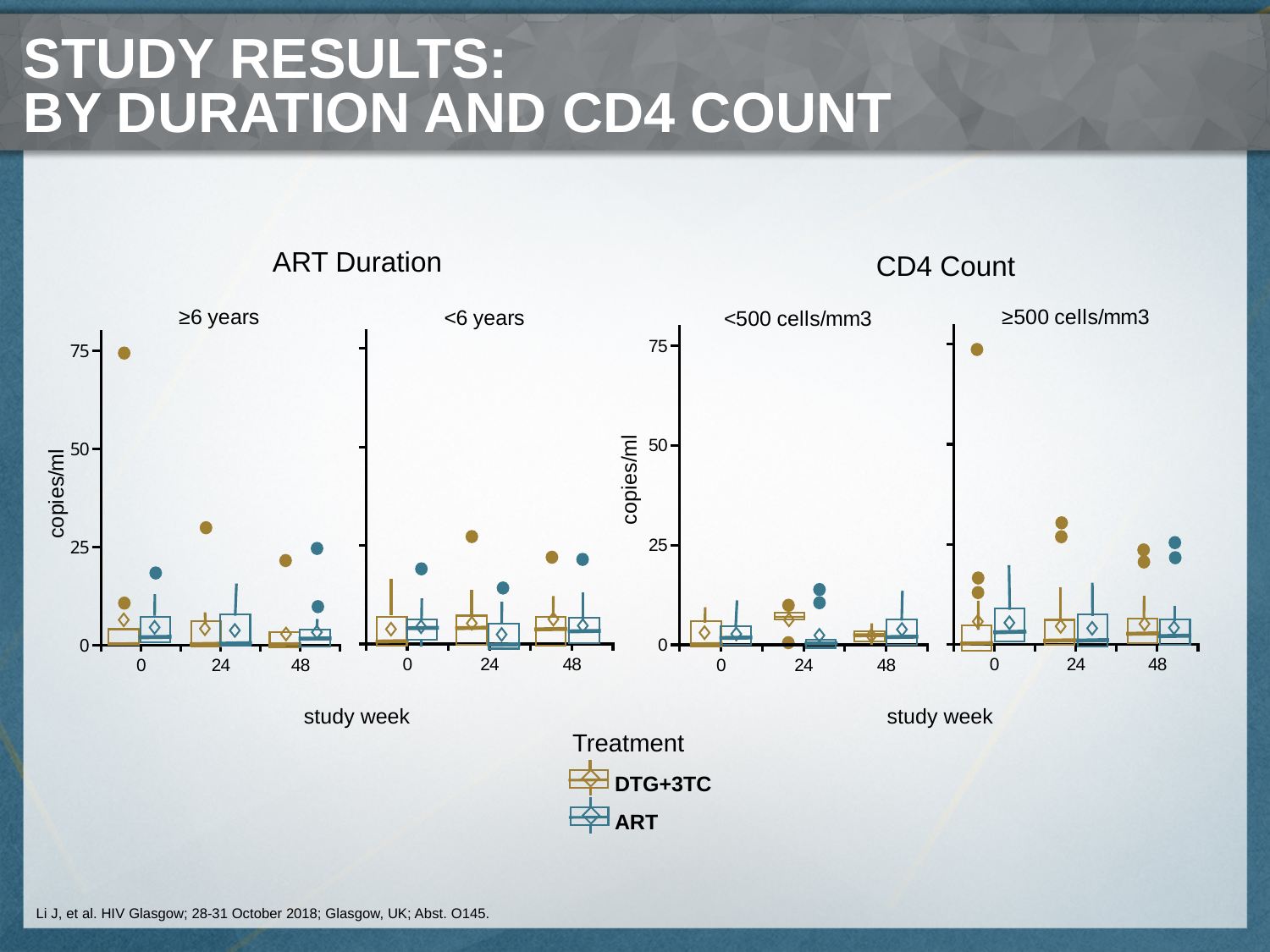
In the ≥6 years panel at week 48, is the highest ART outlier greater or less than 50 copies/ml? less How many treatment series does the Treatment legend list? 2 What kind of chart is used in the ART Duration and CD4 Count panels? Box plot What are the two treatment entries in the legend? DTG+3TC and ART In the <500 cells/mm3 panel, is the highest plotted value greater or less than 25 copies/ml? less What is the y-axis label on the charts? copies/ml How many subgroup panels are shown on the slide in total? 4 In the <6 years panel, is the highest outlier at week 24 greater or less than 50 copies/ml? less In the ≥6 years panel at week 0, which treatment has the higher outlier, DTG+3TC or ART? DTG+3TC How many study week time points are shown on the x axis of each panel? 3